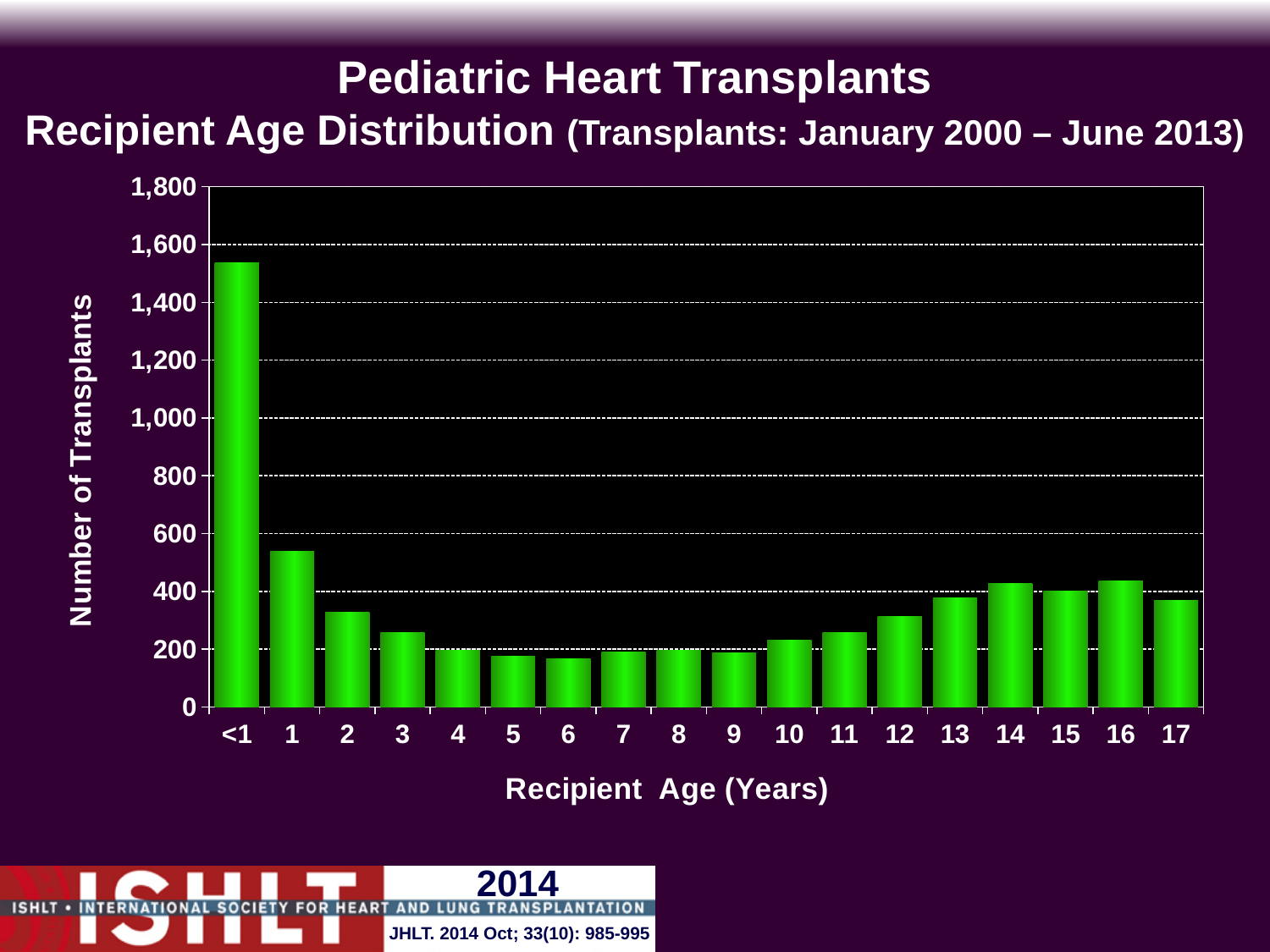
Is the number of transplants for recipients aged 1 greater or less than 600? less Is the number of transplants for recipients aged 14 greater or less than 400? greater Which recipient age category has the highest number of transplants? <1 Is the number of transplants for recipients aged 12 greater or less than 400? less What is the label of the y axis? Number of Transplants What kind of chart is shown on the slide? bar chart Which has more transplants: recipients aged 16 or recipients aged 17? 16 How many recipient age categories are shown on the x axis? 18 What is the label of the x axis? Recipient Age (Years) Which has more transplants: recipients aged 4 or recipients aged 14? 14